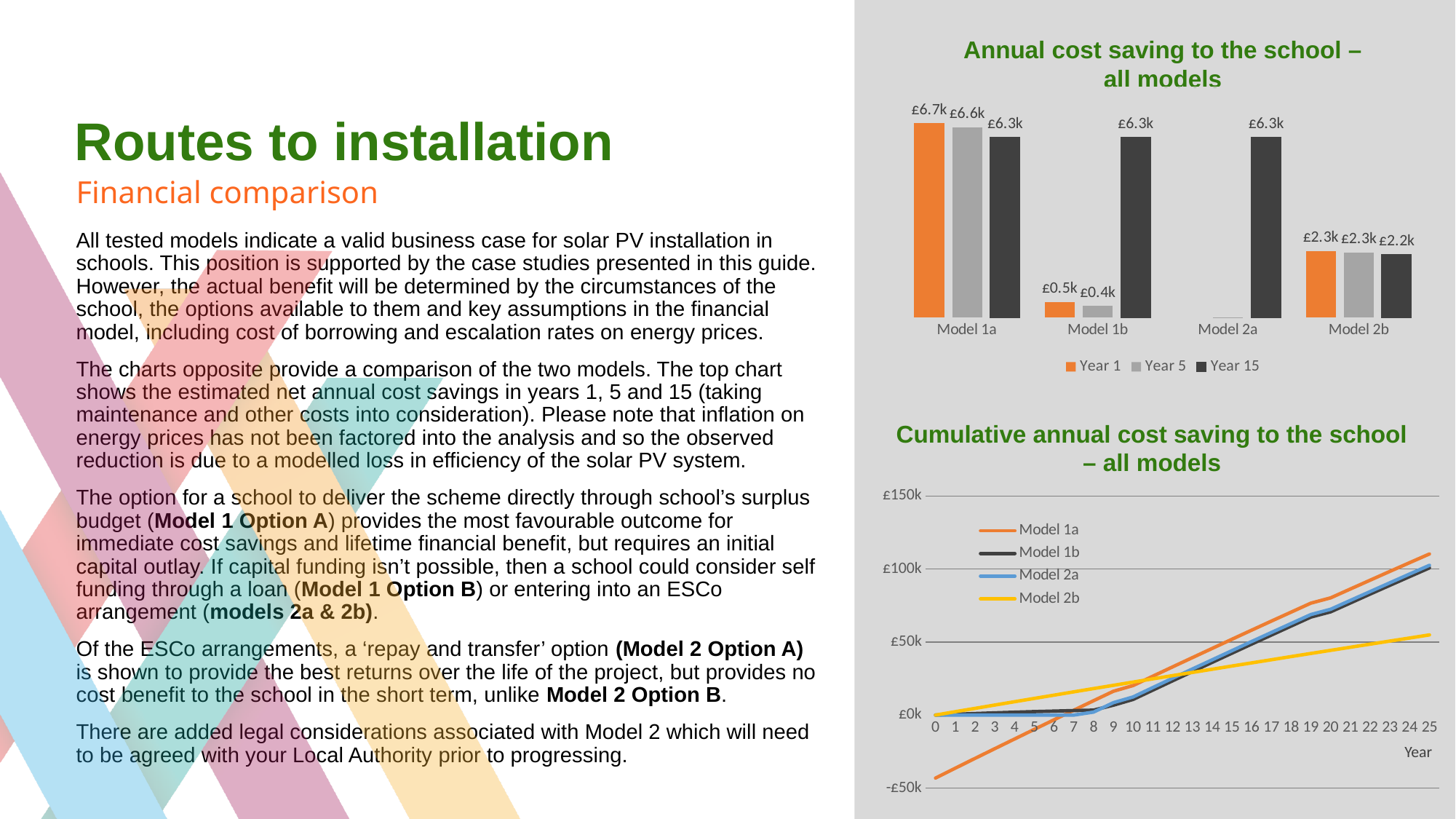
In the 'Annual cost saving to the school – all models' chart, what is the difference between the Year 1 and Year 15 values for Model 1a? £0.4k In the 'Annual cost saving to the school – all models' chart, what is the Year 15 value for Model 2b? £2.2k In the 'Cumulative annual cost saving to the school – all models' chart, does the Model 2b line rise or fall as the year increases? Rises In the 'Annual cost saving to the school – all models' chart, what is the Year 1 value for Model 1a? £6.7k How many models (categories) are shown on the x axis of the 'Annual cost saving to the school – all models' chart? 4 In the 'Annual cost saving to the school – all models' chart, what is the Year 5 value for Model 1b? £0.4k What kind of chart is the 'Cumulative annual cost saving to the school – all models' chart? Line chart In the 'Annual cost saving to the school – all models' chart, which has the larger Year 1 value, Model 1b or Model 2b? Model 2b How many series does the legend of the 'Annual cost saving to the school – all models' chart list? 3 In the 'Annual cost saving to the school – all models' chart, which model has the highest Year 1 value? Model 1a In the 'Cumulative annual cost saving to the school – all models' chart, is the value for Model 1a at year 25 greater or less than £100k? greater In the 'Annual cost saving to the school – all models' chart, which model has the lowest Year 15 value? Model 2b